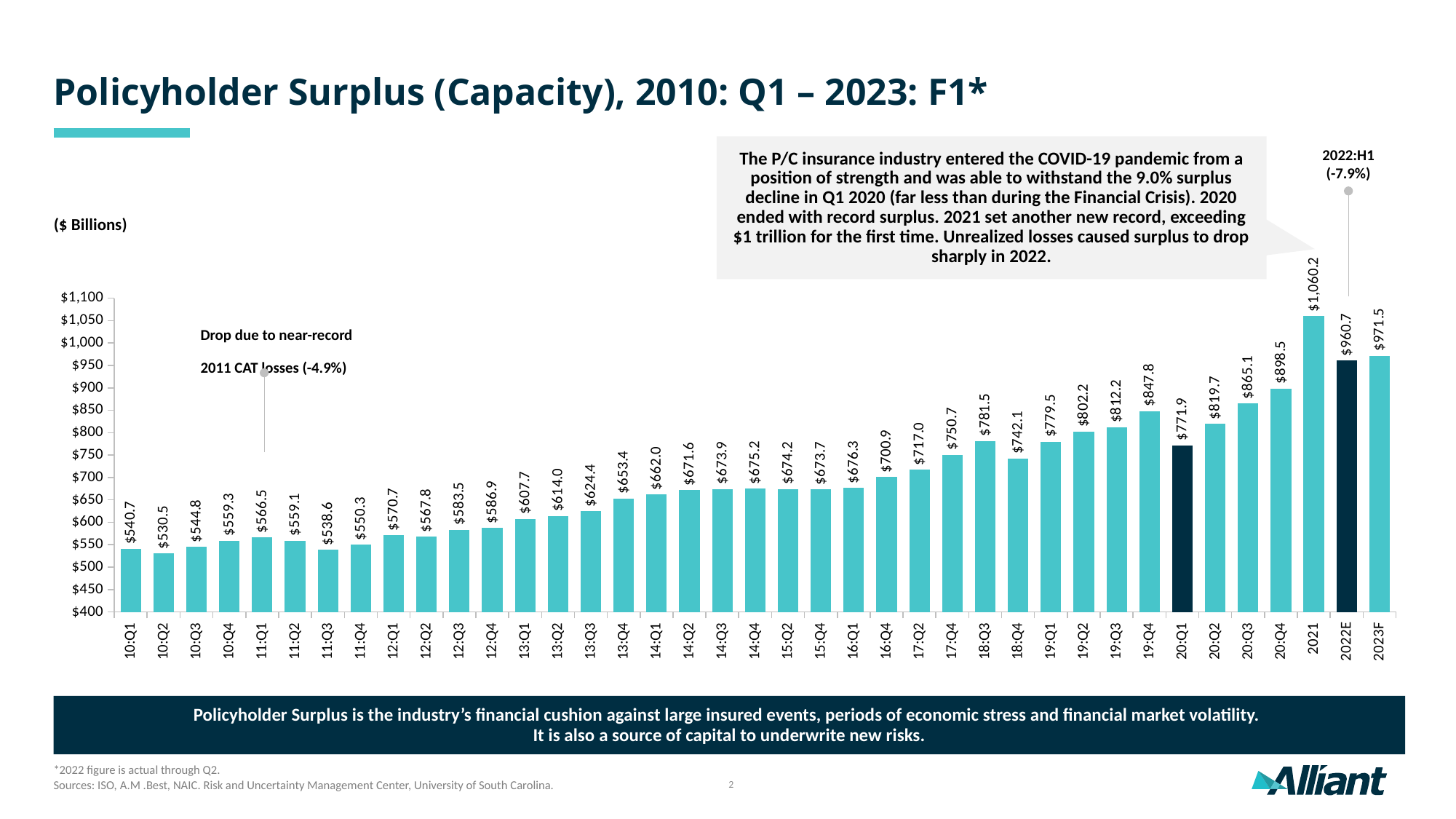
What kind of chart is shown on the slide? Bar chart Do the values generally rise or fall from 10:Q1 to 2021? Rise Which period has the lowest policyholder surplus? 10:Q2 What is the value shown for 20:Q1? $771.9 What is the value shown for 2023F? $971.5 What is the difference between the 19:Q4 value and the 20:Q1 value? $75.9 What is the policyholder surplus value for 2021? $1,060.2 Which is larger, the value for 18:Q3 or the value for 18:Q4? 18:Q3 In what units are the values on the chart expressed? $ Billions Which period has the highest policyholder surplus? 2021 What is the difference between the 2021 value and the 2022E value? $99.5 How many periods (bars) are plotted on the chart? 39